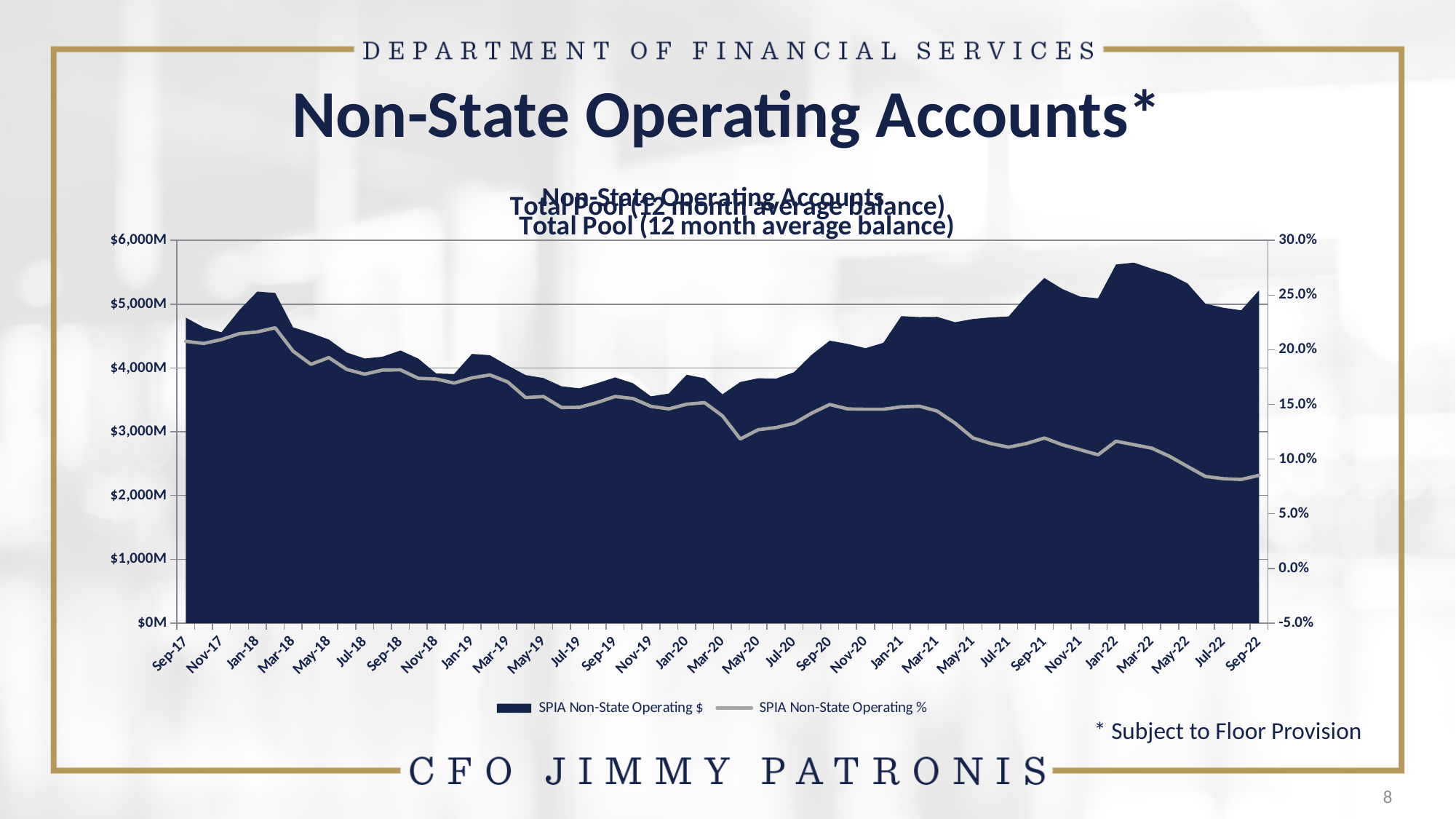
Is the SPIA Non-State Operating $ value for Sep-17 greater or less than $4,000M? greater Is the SPIA Non-State Operating $ value for Mar-22 greater or less than $5,000M? greater Which is larger, the SPIA Non-State Operating % value for Sep-17 or for Sep-22? Sep-17 What kind of chart is shown on the slide? Area chart with a line series Does the SPIA Non-State Operating % line rise or fall overall from Sep-17 to Sep-22? fall How many series does the chart legend list? 2 Is the SPIA Non-State Operating % value for Jul-21 greater or less than 15.0%? less Which is larger, the SPIA Non-State Operating $ value for Sep-17 or for Sep-22? Sep-22 What are the two series named in the chart legend? SPIA Non-State Operating $ and SPIA Non-State Operating %